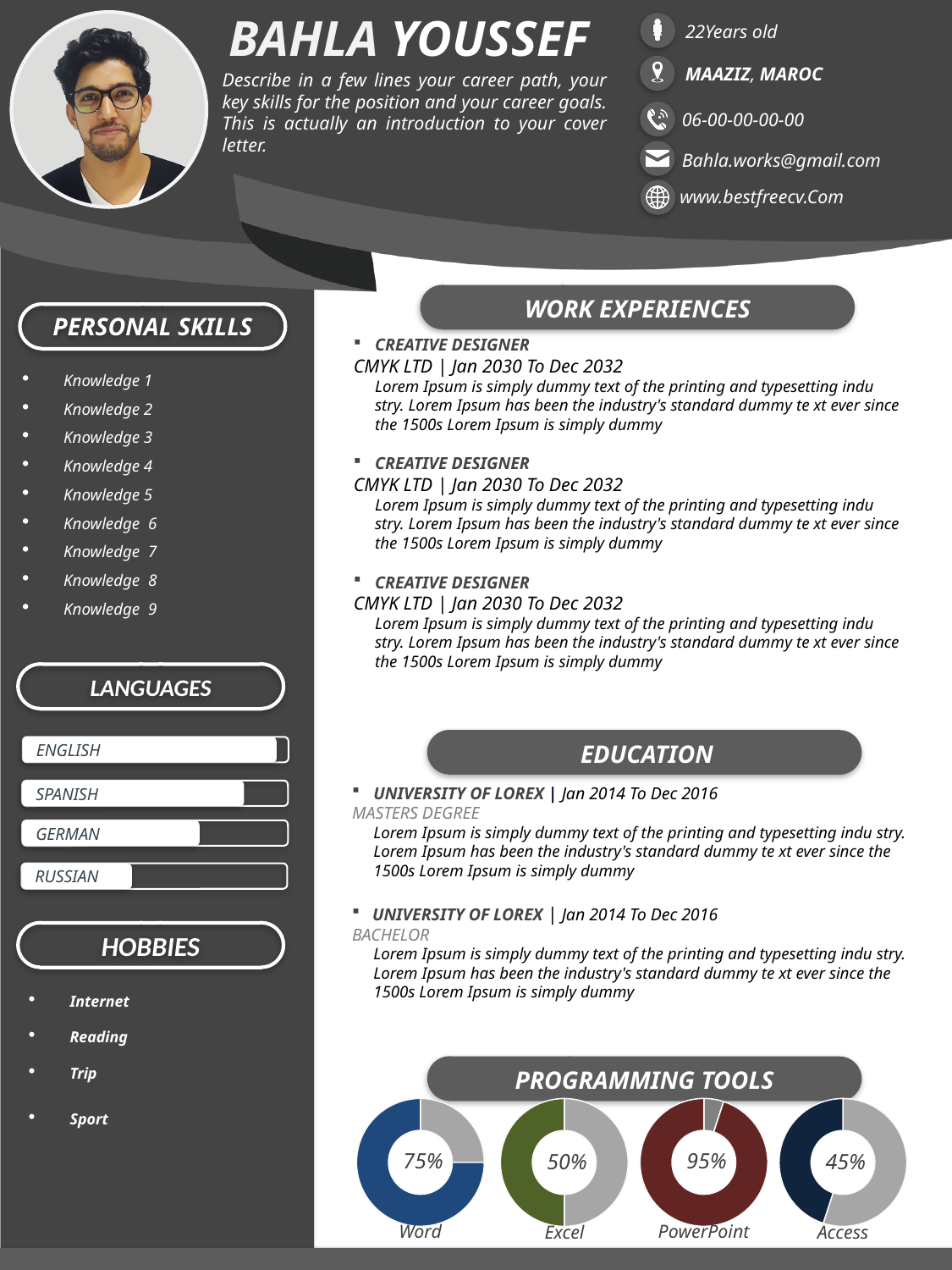
In the Programming Tools section, what is the difference between the PowerPoint and Word percentages? 20% Among the Programming Tools charts, which tool has the highest percentage? PowerPoint In the Programming Tools section, which has a higher percentage, Word or Excel? Word In the Programming Tools section, what percentage is shown for PowerPoint? 95% In the Programming Tools section, what percentage is shown for Word? 75% What is the title of the section containing the four donut charts? PROGRAMMING TOOLS What kind of chart is used for each tool in the Programming Tools section? Donut chart In the Programming Tools section, what percentage is shown for Access? 45% Among the Programming Tools charts, which tool has the lowest percentage? Access In the Programming Tools section, what is the difference between the Excel and Access percentages? 5% In the Programming Tools section, what percentage is shown for Excel? 50% How many programming tools are shown as charts in the Programming Tools section? 4